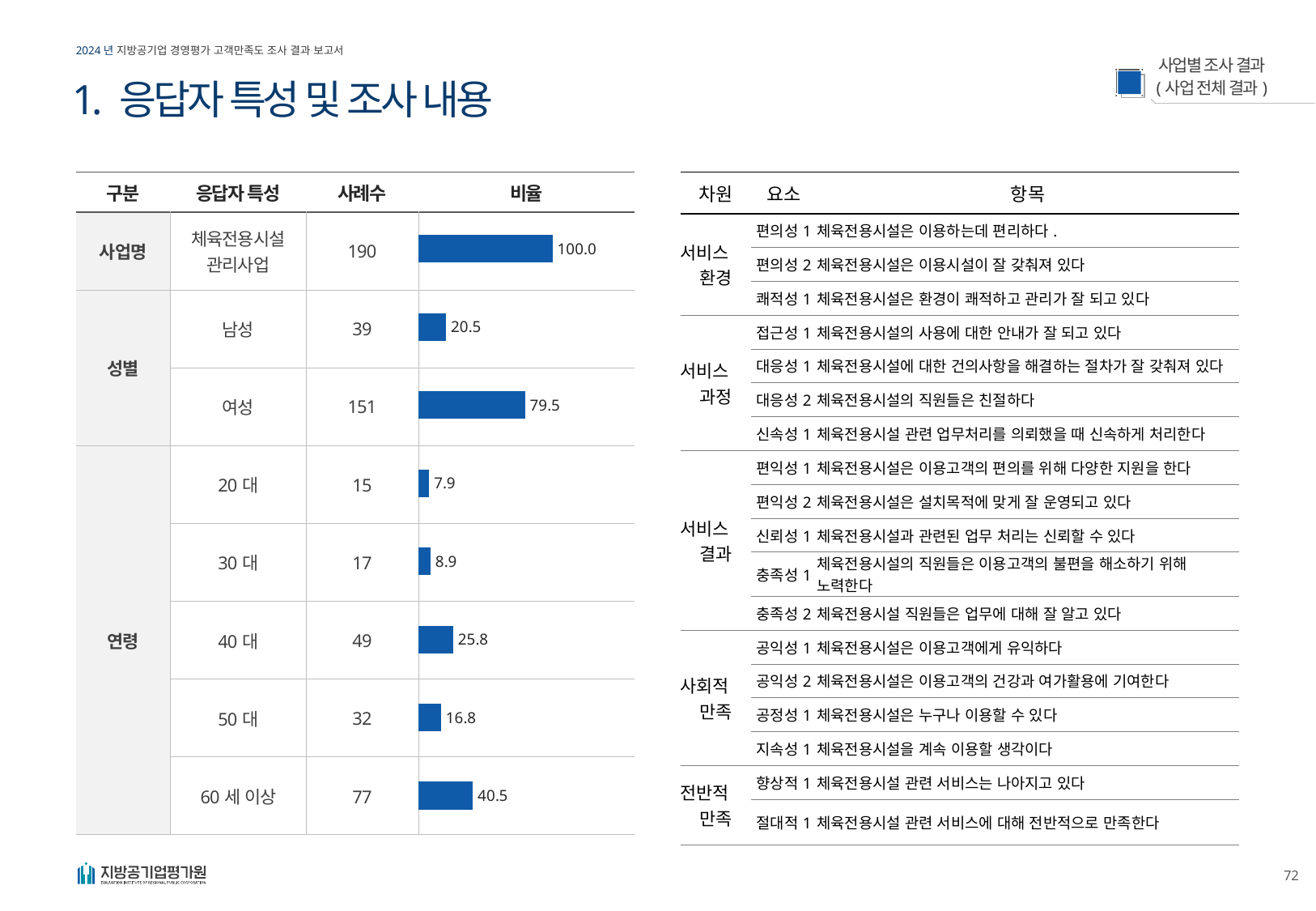
Which has a larger 비율, 50 대 or 30 대? 50 대 What is the 비율 value shown for 60 세 이상? 40.5 Among the 연령 groups (20 대 to 60 세 이상), which has the highest 비율? 60 세 이상 What is the 비율 value shown for 남성? 20.5 What is the 비율 value shown for 40 대? 25.8 Among the 연령 groups (20 대 to 60 세 이상), which has the lowest 비율? 20 대 What colour are the bars in the 비율 column? Blue How many 연령 groups are shown with bars in the 비율 column? 5 What is the difference between the 비율 values for 여성 and 남성? 59.0 What kind of chart is used in the 비율 column of the table? Bar chart What is the difference between the 비율 values for 60 세 이상 and 40 대? 14.7 What is the 비율 value shown for 여성? 79.5